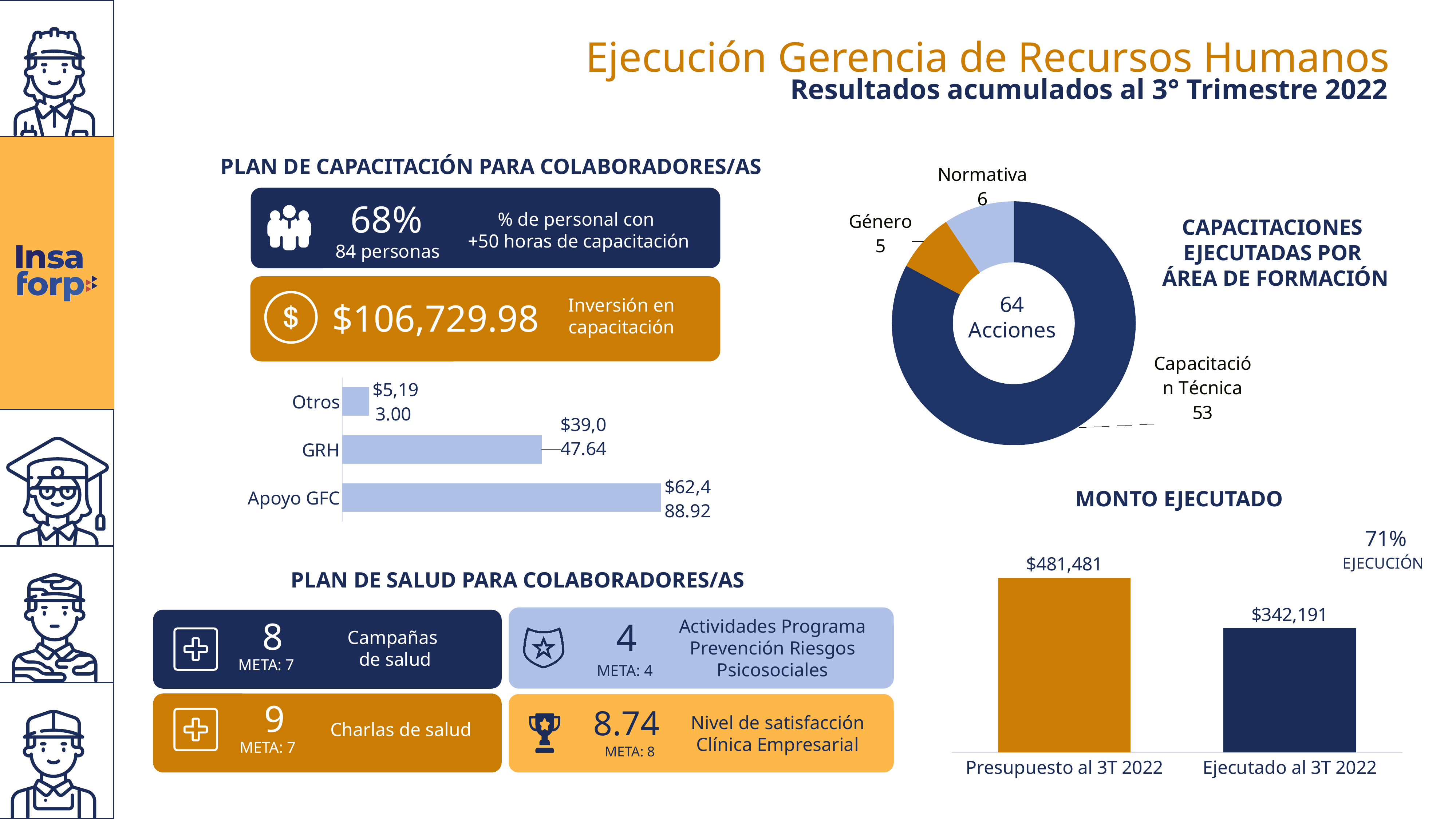
In the MONTO EJECUTADO chart, what is the value for Presupuesto al 3T 2022? $481,481 In the horizontal bar chart under PLAN DE CAPACITACIÓN PARA COLABORADORES/AS, what is the value for GRH? $39,047.64 In the horizontal bar chart under PLAN DE CAPACITACIÓN PARA COLABORADORES/AS, how many categories are shown? 3 What kind of chart is the MONTO EJECUTADO chart? Bar chart In the MONTO EJECUTADO chart, which bar is taller, Presupuesto al 3T 2022 or Ejecutado al 3T 2022? Presupuesto al 3T 2022 In the donut chart CAPACITACIONES EJECUTADAS POR ÁREA DE FORMACIÓN, how many actions are for Capacitación Técnica? 53 In the MONTO EJECUTADO chart, what is the difference between Presupuesto al 3T 2022 and Ejecutado al 3T 2022? $139,290 In the donut chart CAPACITACIONES EJECUTADAS POR ÁREA DE FORMACIÓN, which area has the fewest actions? Género In the donut chart CAPACITACIONES EJECUTADAS POR ÁREA DE FORMACIÓN, how many areas are shown? 3 In the horizontal bar chart under PLAN DE CAPACITACIÓN PARA COLABORADORES/AS, which category has the highest value? Apoyo GFC In the MONTO EJECUTADO chart, what is the value for Ejecutado al 3T 2022? $342,191 In the donut chart CAPACITACIONES EJECUTADAS POR ÁREA DE FORMACIÓN, what total number of actions is shown in the centre? 64 Acciones